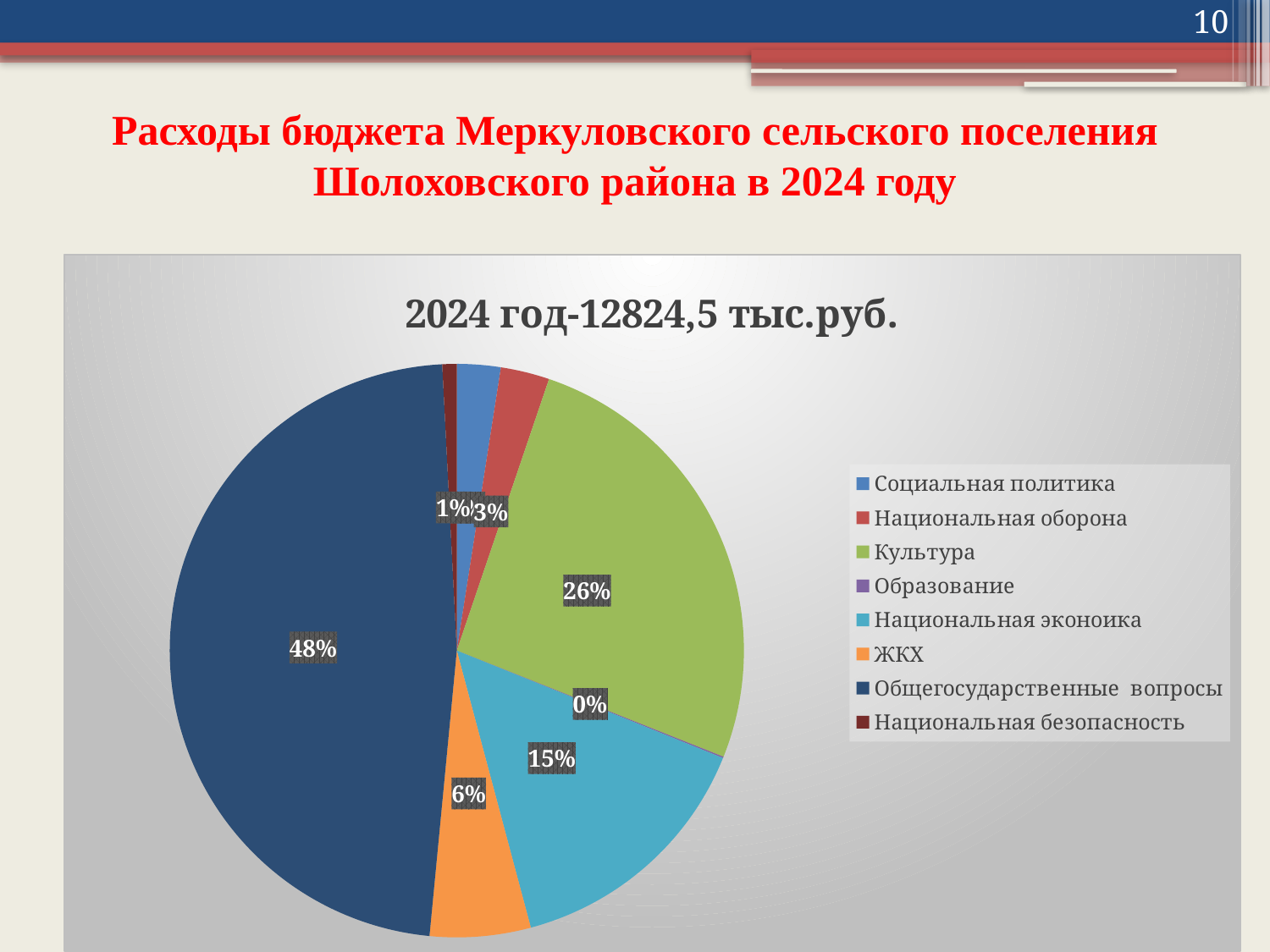
What share of the pie does Образование take? 0% Which is larger, the share for Культура or the share for Национальная экономика? Культура What is the title of the chart? 2024 год-12824,5 тыс.руб. What share of the pie does ЖКХ take? 6% What share of the pie does Общегосударственные вопросы take? 48% Which category has the smallest share according to the data labels? Образование Which category has the largest slice of the pie? Общегосударственные вопросы How many entries does the chart legend list? 8 What kind of chart is shown on the slide? pie chart What is the difference in percentage points between the shares of Общегосударственные вопросы and Культура? 22